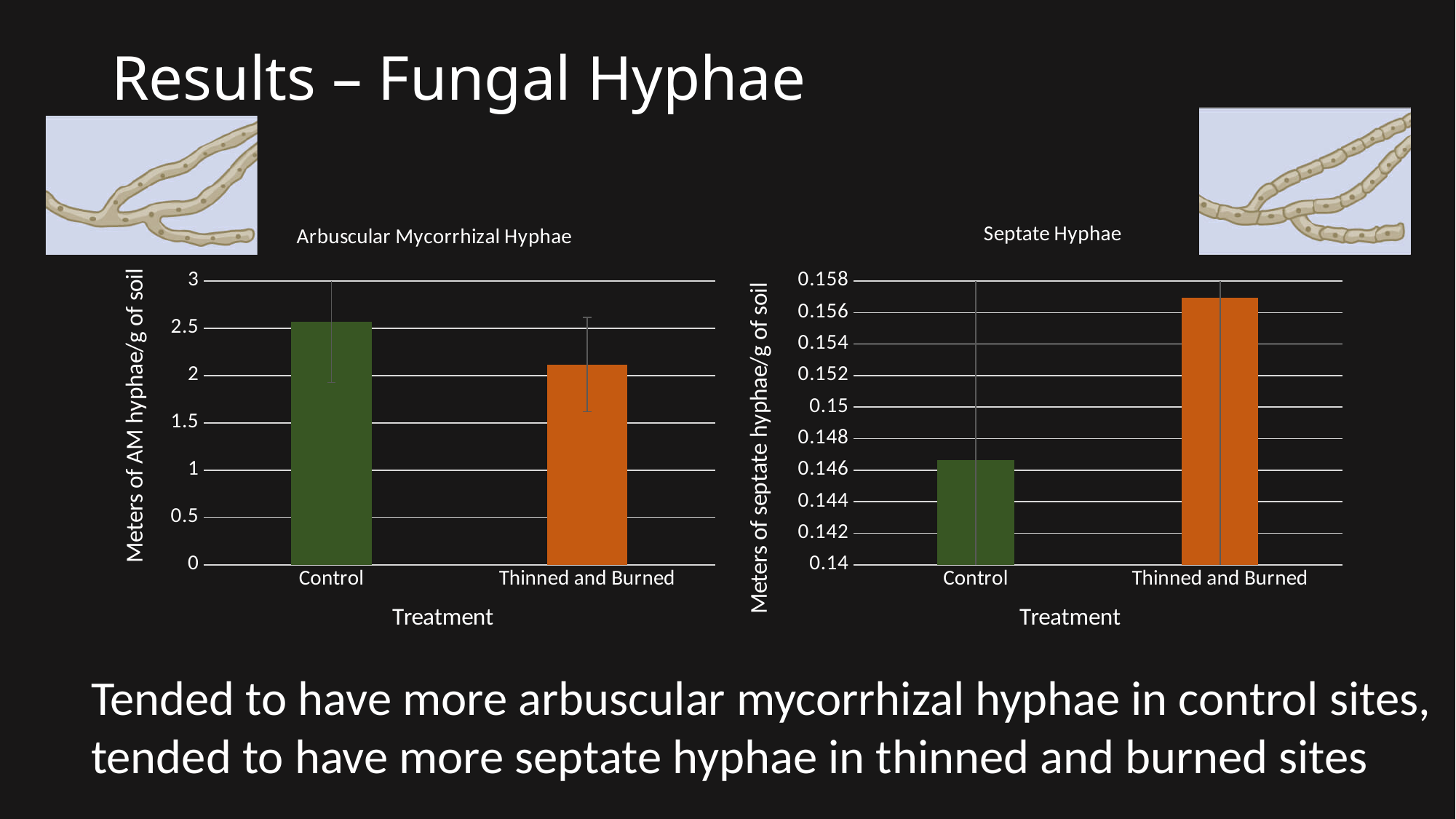
In the Arbuscular Mycorrhizal Hyphae chart, is the value for Thinned and Burned greater or less than 1.5? greater In the Septate Hyphae chart, is the value for Control larger or smaller than the value for Thinned and Burned? smaller How many treatment categories are shown in the Arbuscular Mycorrhizal Hyphae chart? 2 What type of chart is the Arbuscular Mycorrhizal Hyphae chart? bar chart In the Arbuscular Mycorrhizal Hyphae chart, is the value for Thinned and Burned greater or less than 2.5? less What is the y-axis title of the Arbuscular Mycorrhizal Hyphae chart? Meters of AM hyphae/g of soil In the Septate Hyphae chart, which treatment has the lower value? Control In the Arbuscular Mycorrhizal Hyphae chart, which treatment has the higher value? Control In the Septate Hyphae chart, is the value for Thinned and Burned greater or less than 0.154? greater What is the x-axis title of the Septate Hyphae chart? Treatment